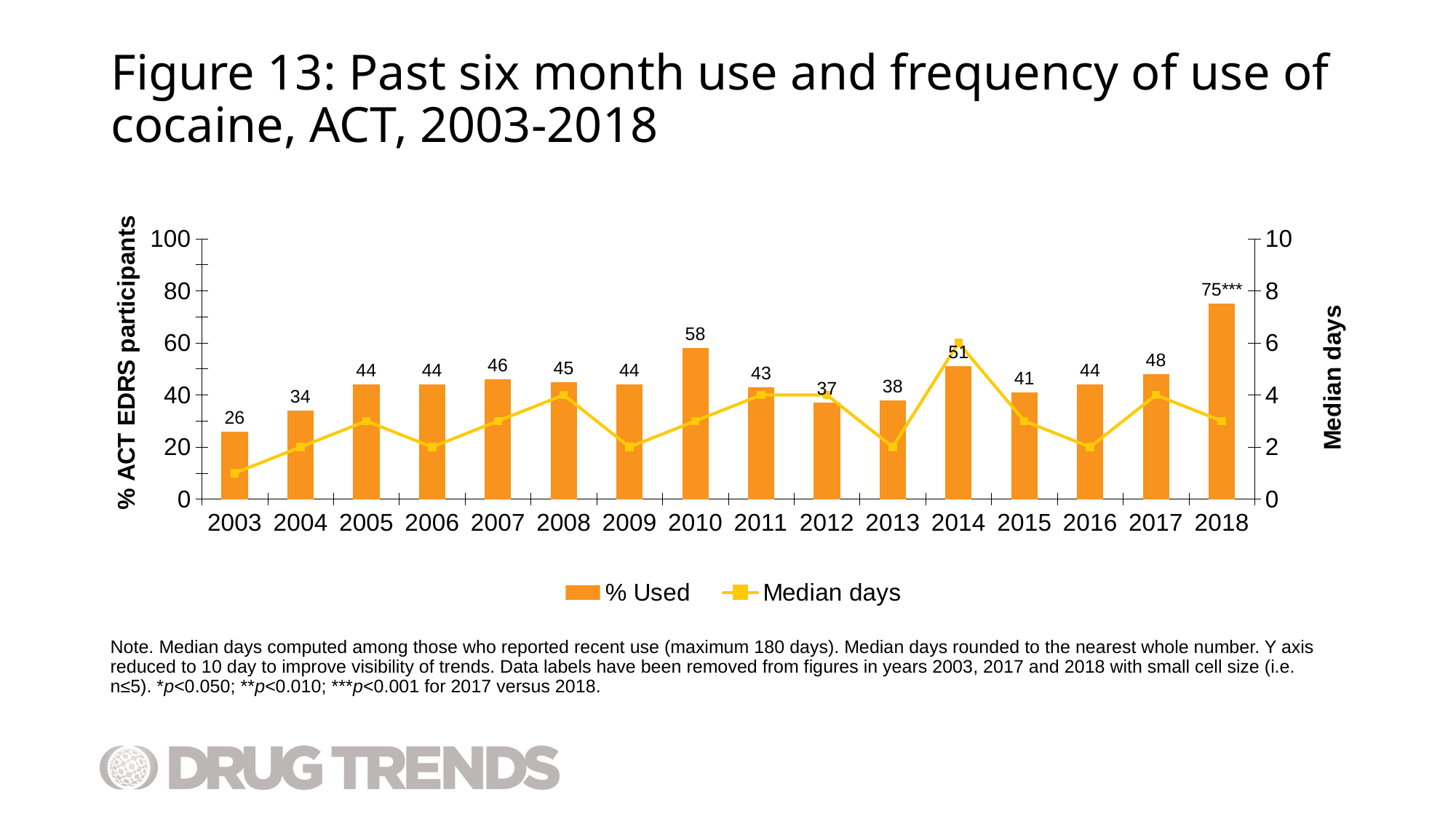
How many years are shown on the x axis? 16 Which year has the lowest % Used value? 2003 Which year has a larger % Used value, 2014 or 2017? 2014 What is the difference between the % Used values for 2010 and 2012? 21 Is the Median days value for 2003 greater or less than 2? less What is the label of the right-hand y axis? Median days What is the % Used value for 2010? 58 How many series does the legend list? 2 What is the % Used value for 2003? 26 What is the data label shown on the % Used bar for 2018? 75*** Is the Median days value for 2014 greater or less than 4? greater Which year has the highest % Used value? 2018